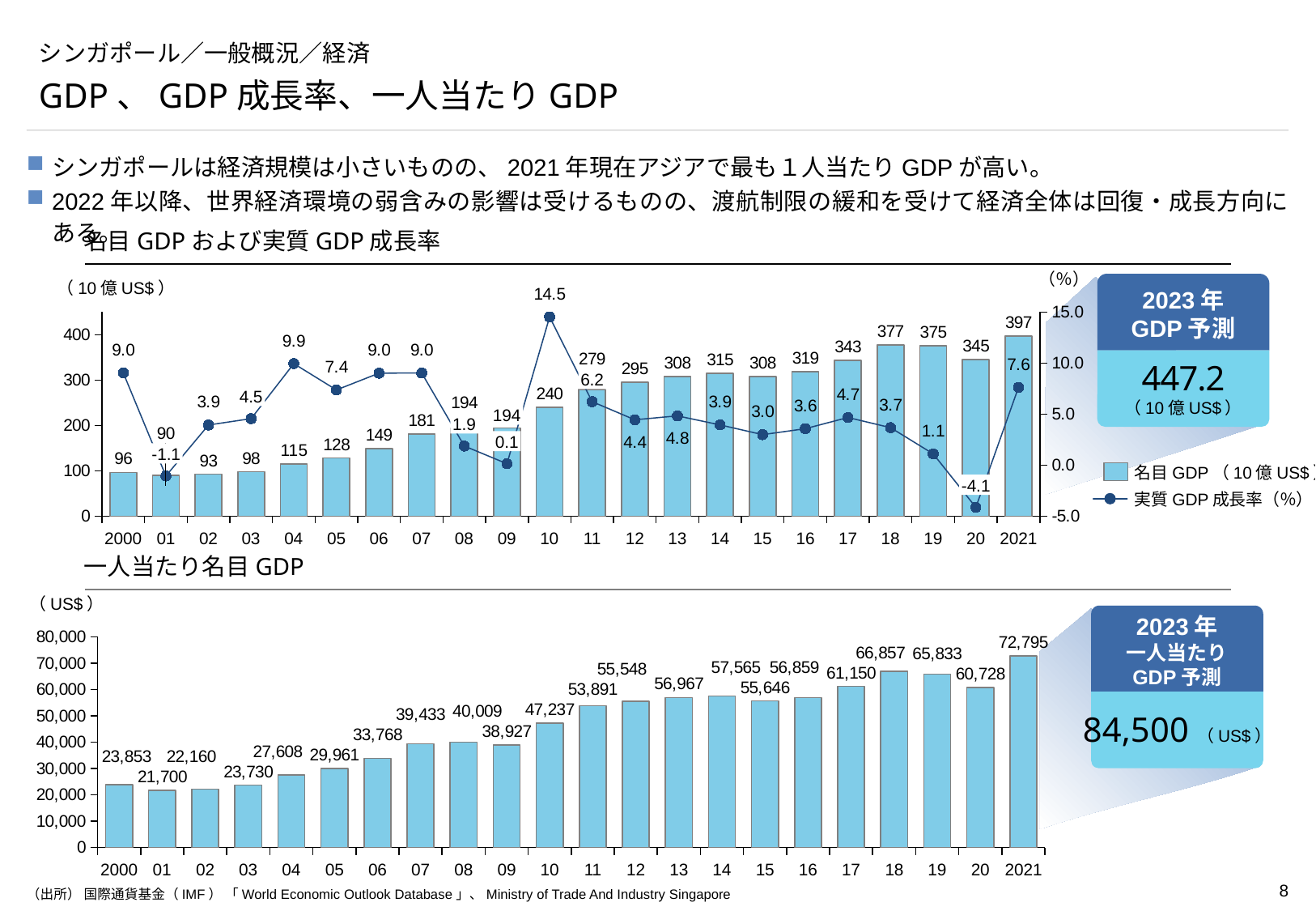
In the top chart (名目GDPおよび実質GDP成長率), how many series does the legend list? 2 In the top chart (名目GDPおよび実質GDP成長率), what is the real GDP growth rate for 2010? 14.5 In the top chart (名目GDPおよび実質GDP成長率), which year has the lowest real GDP growth rate? 20 What kind of chart is the bottom chart (一人当たり名目GDP)? bar chart In the top chart (名目GDPおよび実質GDP成長率), what is the difference between the nominal GDP of 2021 and 2020? 52 In the bottom chart (一人当たり名目GDP), what is the difference between the values for 2021 and 2020? 12,067 In the bottom chart (一人当たり名目GDP), what is the value for 2021? 72,795 In the top chart (名目GDPおよび実質GDP成長率), is the nominal GDP for 2018 greater or less than the nominal GDP for 2019? greater In the bottom chart (一人当たり名目GDP), how many years are plotted? 22 In the top chart (名目GDPおよび実質GDP成長率), what is the nominal GDP value for 2021? 397 What is the 2023 per-capita GDP forecast shown next to the bottom chart? 84,500 (US$) In the bottom chart (一人当たり名目GDP), which year has the lowest value? 01